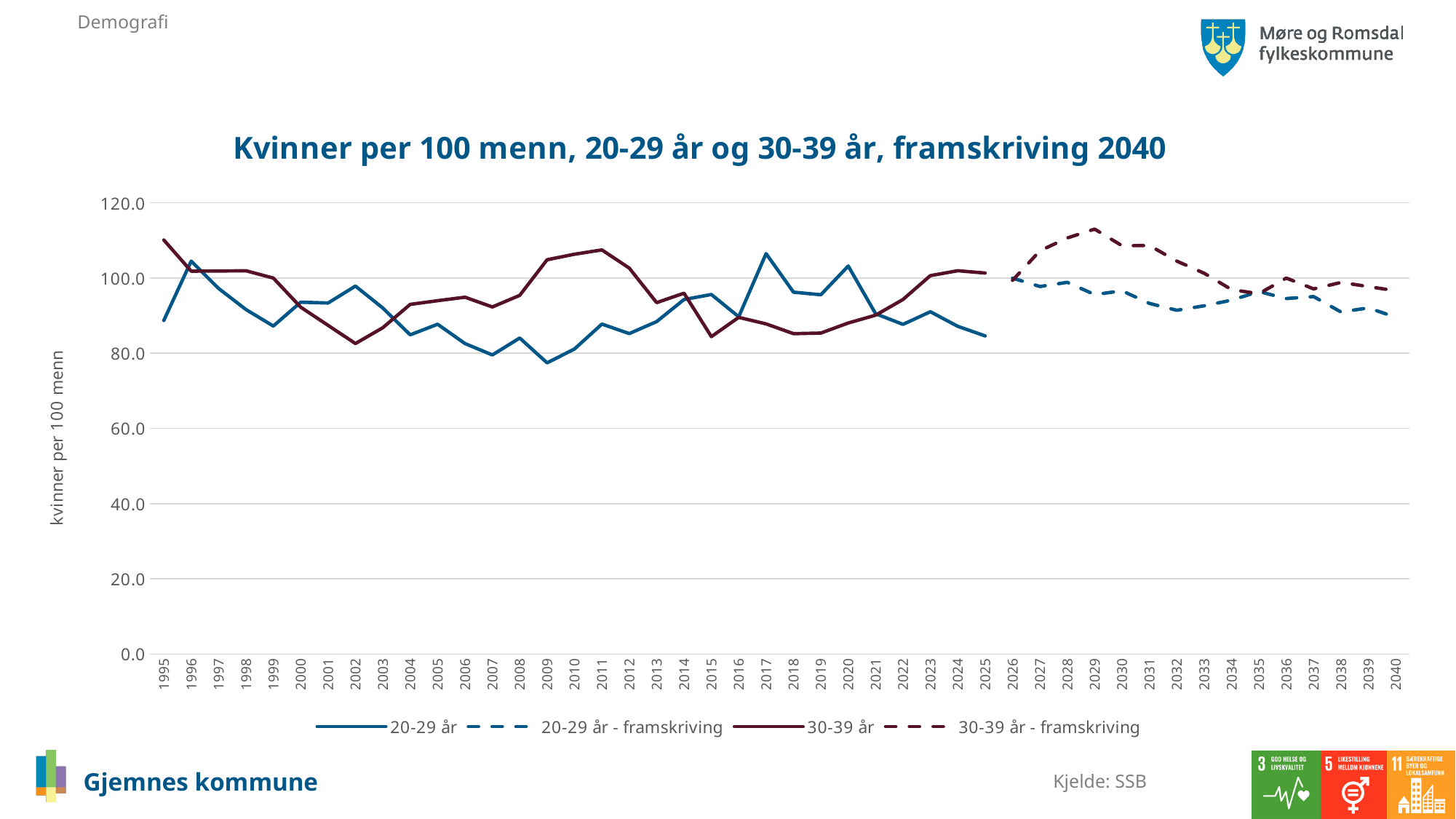
In which year does the 30-39 år - framskriving series reach its highest value? 2029 In 2017, which series has the higher value: 20-29 år or 30-39 år? 20-29 år In 1995, which series has the higher value: 20-29 år or 30-39 år? 30-39 år Is the value for 30-39 år - framskriving in 2029 greater or less than 100? greater Is the value for 30-39 år in 1995 greater or less than 100? greater What kind of chart is shown on the slide? Line chart What is the label on the y axis? kvinner per 100 menn Is the value for 20-29 år in 2017 greater or less than 100? greater How many series does the legend list? 4 How many years are shown on the x axis, from 1995 to 2040? 46 What is the title of the chart? Kvinner per 100 menn, 20-29 år og 30-39 år, framskriving 2040